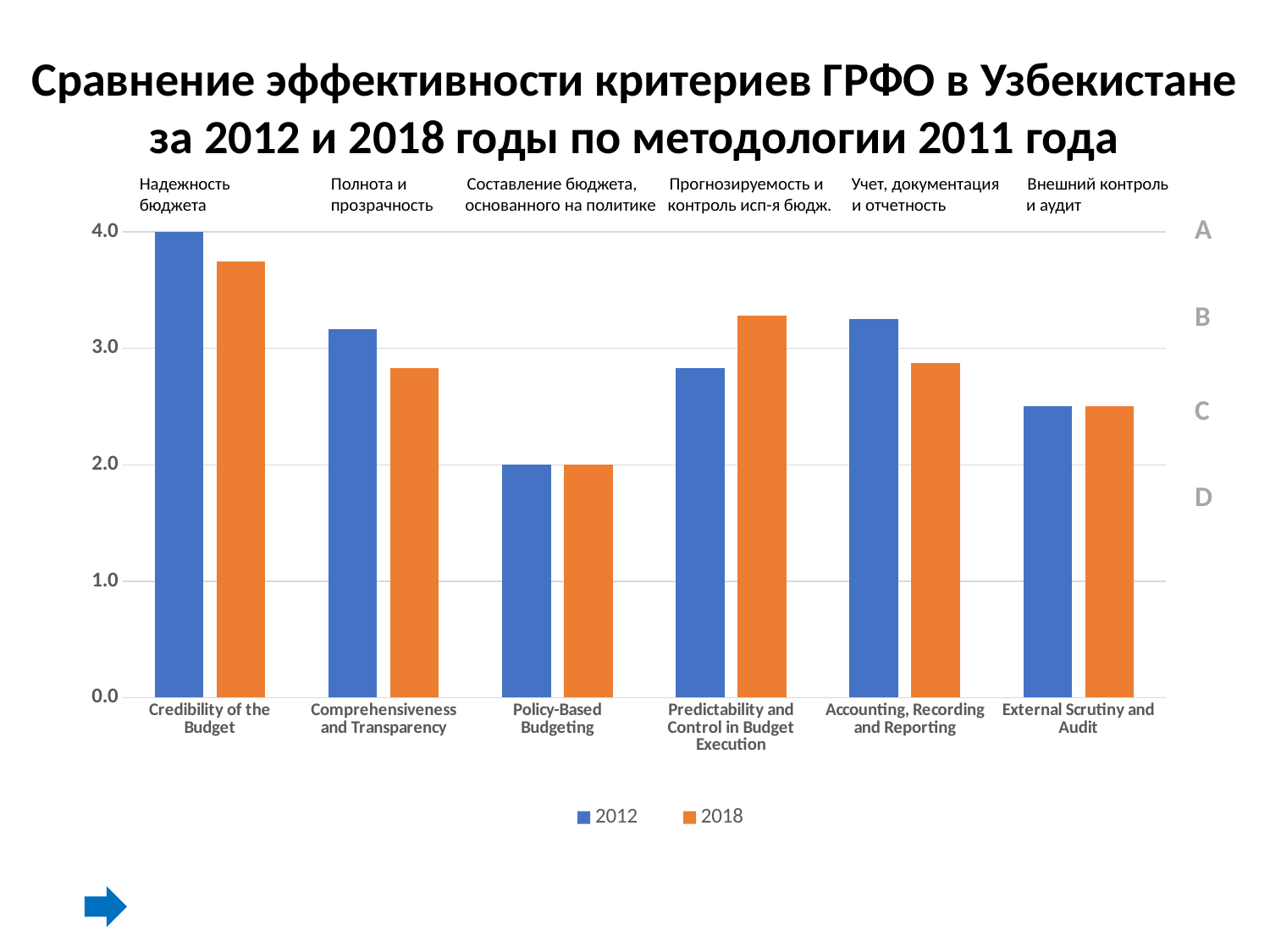
Is the 2018 value for Predictability and Control in Budget Execution greater or less than 3.0? greater Which category has the highest 2018 value? Credibility of the Budget Is the 2018 value for Comprehensiveness and Transparency greater or less than 3.0? less What is the 2018 value for Policy-Based Budgeting? 2.0 How many categories are shown on the x axis? 6 For Predictability and Control in Budget Execution, which year has the larger value, 2012 or 2018? 2018 What kind of chart is shown on the slide? bar chart How many series does the legend list? 2 Which category has the highest 2012 value? Credibility of the Budget What is the 2012 value for Credibility of the Budget? 4.0 What are the two entries in the legend? 2012 and 2018 Which category has the lowest 2012 value? Policy-Based Budgeting